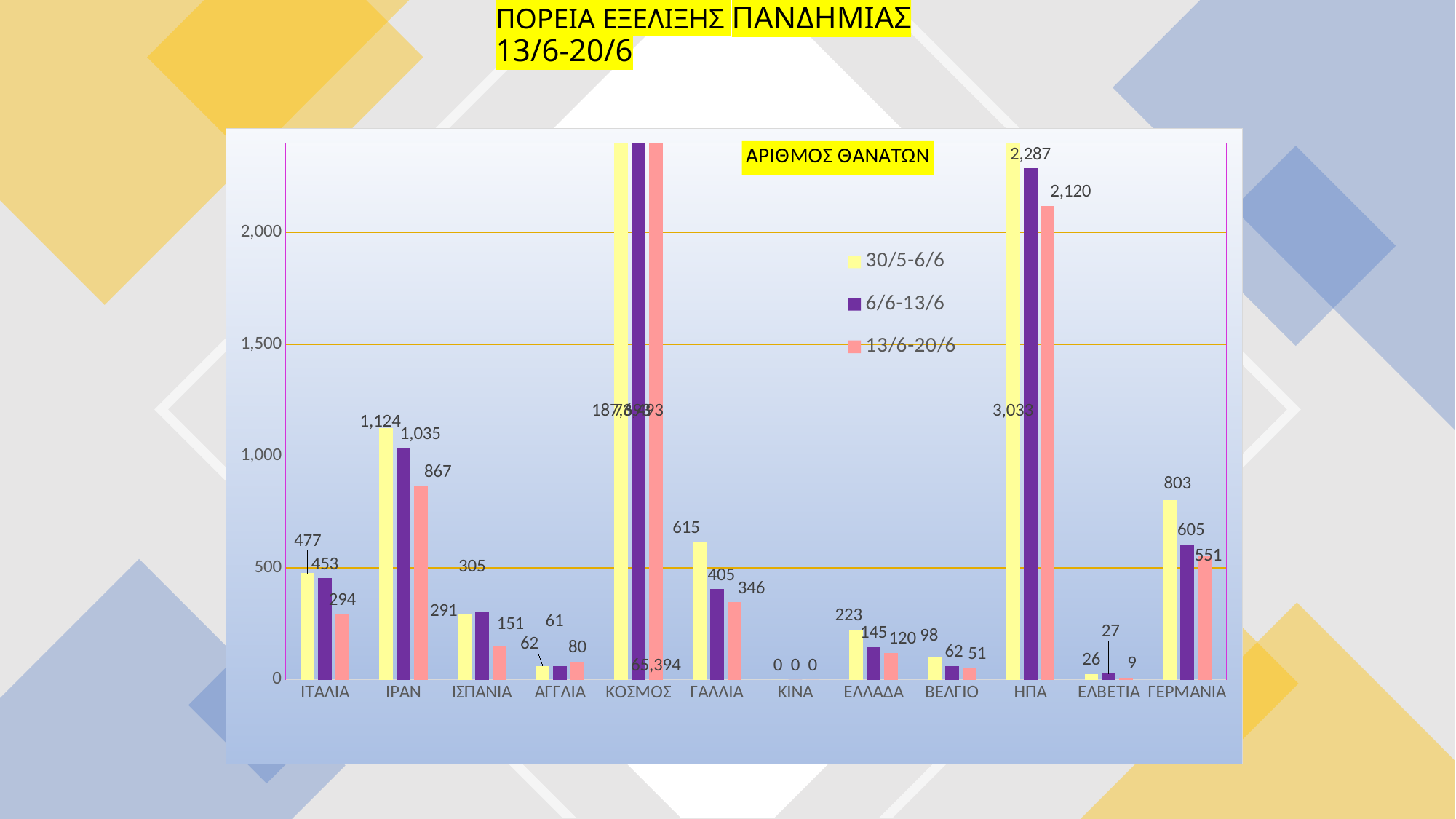
Which is larger for ΙΤΑΛΙΑ: the 30/5-6/6 value or the 13/6-20/6 value? 30/5-6/6 Which category has the lowest values across all three series? ΚΙΝΑ What is the value for ΗΠΑ in the 6/6-13/6 series? 2,287 What type of chart is shown on the slide? bar chart What is the value for ΓΕΡΜΑΝΙΑ in the 30/5-6/6 series? 803 How many series does the legend list? 3 What is the title of the chart? ΑΡΙΘΜΟΣ ΘΑΝΑΤΩΝ What is the difference between the 30/5-6/6 and 13/6-20/6 values for ΓΑΛΛΙΑ? 269 What is the value for ΕΛΛΑΔΑ in the 13/6-20/6 series? 120 How many countries/categories are shown on the x axis? 12 Do the values for ΓΕΡΜΑΝΙΑ rise or fall from the 30/5-6/6 series to the 13/6-20/6 series? fall What is the value for ΙΡΑΝ in the 13/6-20/6 series? 867